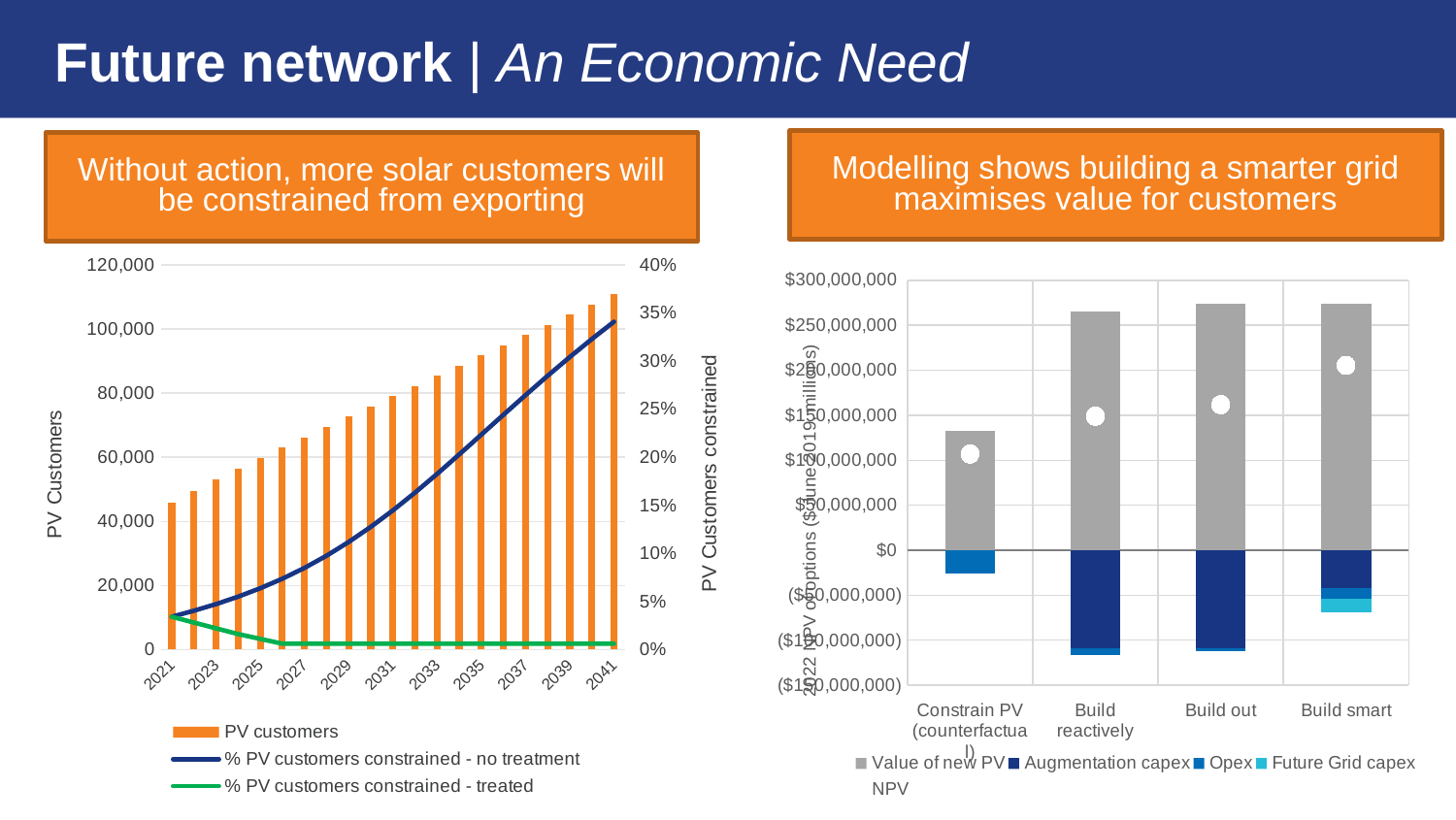
In the left-hand chart, is the '% PV customers constrained - no treatment' value in 2041 greater or less than 30%? greater How many categories are shown on the x axis of the right-hand chart? 4 In the left-hand chart, is the number of PV customers in 2041 greater or less than 100,000? greater How many entries does the legend of the right-hand chart list? 5 In the right-hand chart, which category has the lowest Value of new PV? Constrain PV (counterfactual) In the left-hand chart, does the '% PV customers constrained - treated' line rise or fall between 2021 and 2026? fall In the left-hand chart, do the PV customers bars rise or fall from 2021 to 2041? rise What kind of chart is the right-hand chart titled 'Modelling shows building a smarter grid maximises value for customers'? stacked bar chart In the right-hand chart, is the Value of new PV for 'Constrain PV (counterfactual)' greater or less than $150,000,000? less In the right-hand chart, which category is the only one with a Future Grid capex segment? Build smart How many series does the legend of the left-hand chart ('Without action, more solar customers will be constrained from exporting') list? 3 In the right-hand chart, which category has the highest NPV marker? Build smart